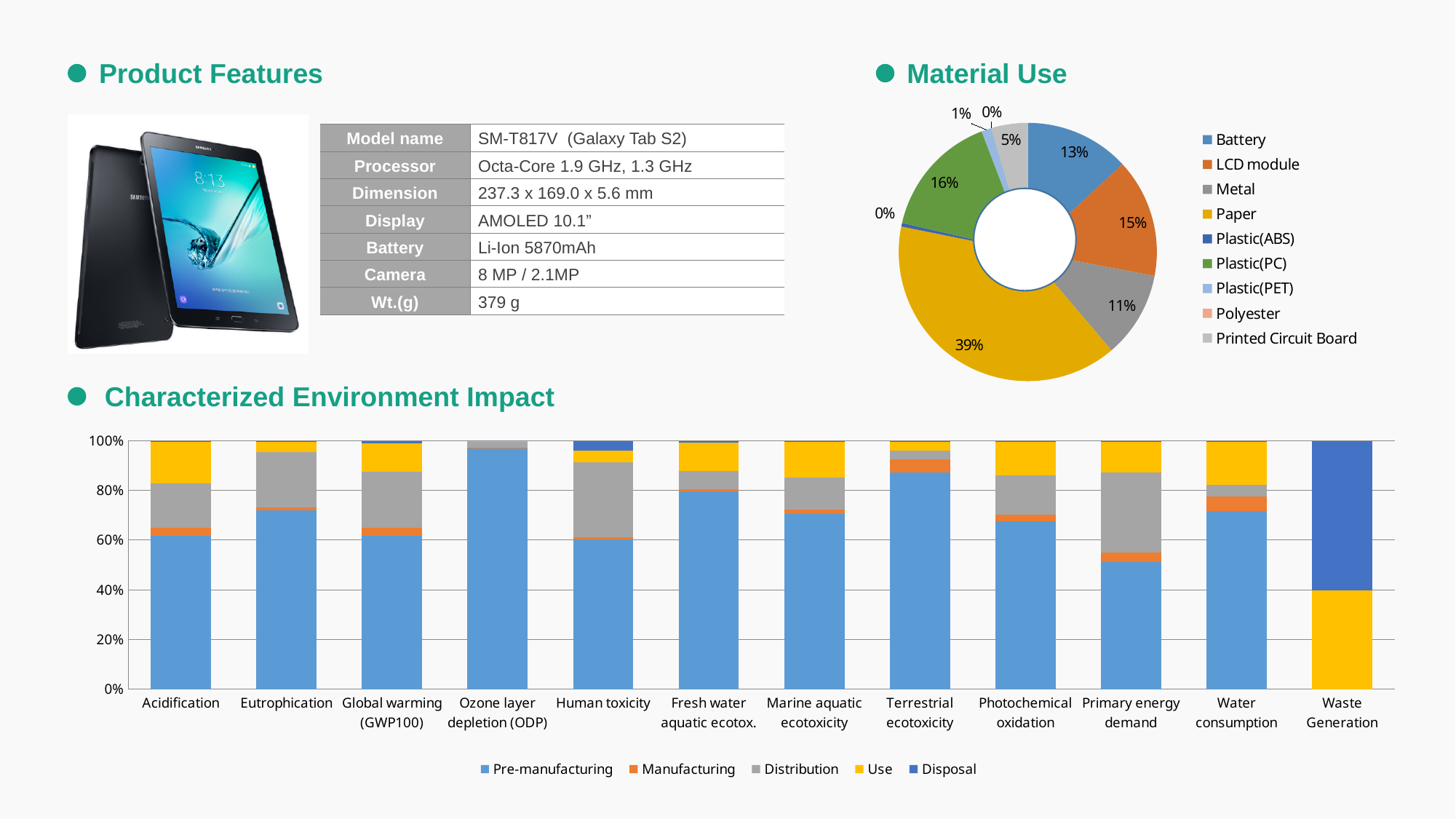
In the Material Use chart, which material has the largest share? Paper In the Material Use chart, what is the difference between the shares of LCD module and Metal? 4% How many impact categories are shown on the x axis of the Characterized Environment Impact chart? 12 How many materials does the legend of the Material Use chart list? 9 In the Material Use chart, which has a larger share, Battery or LCD module? LCD module In the Material Use chart, what share of material use is Plastic(PC)? 16% In the Material Use chart, what share of material use is Paper? 39% In the Characterized Environment Impact chart, is the Pre-manufacturing share for Ozone layer depletion (ODP) greater or less than 80%? greater How many series does the legend of the Characterized Environment Impact chart list? 5 What kind of chart is the Material Use chart? Pie chart In the Material Use chart, what share of material use is Printed Circuit Board? 5% What kind of chart is the Characterized Environment Impact chart? Bar chart